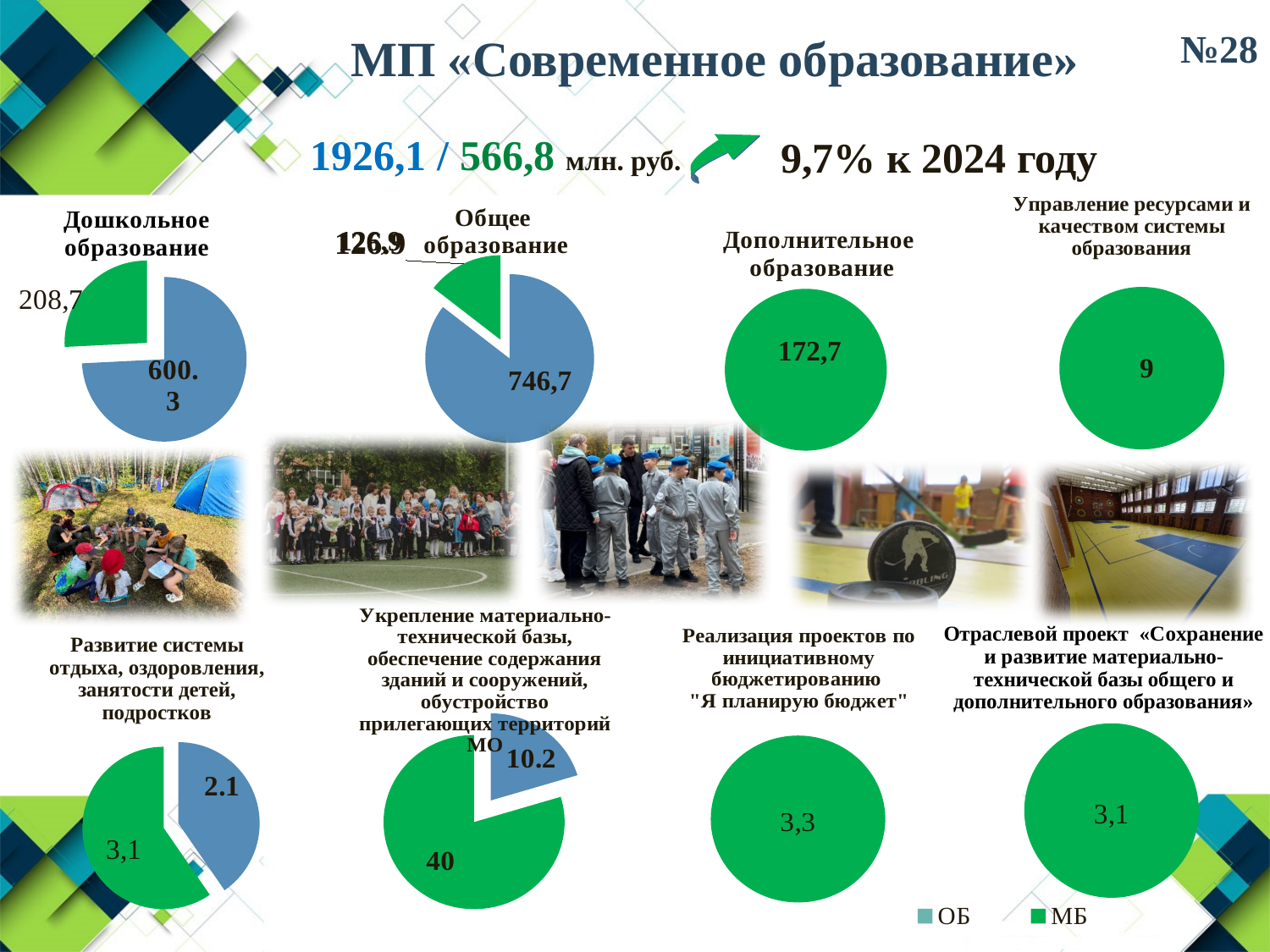
In the "Отраслевой проект" chart, what value is shown? 3,1 In the "Укрепление материально-технической базы" chart, what is the difference between the МБ slice and the ОБ slice? 29.8 In the "Реализация проектов по инициативному бюджетированию" chart, what value is shown? 3,3 In the "Развитие системы отдыха, оздоровления, занятости детей, подростков" chart, what is the value of the blue (ОБ) slice? 2.1 In the "Общее образование" chart, what is the value of the blue slice? 746,7 In the "Дополнительное образование" chart, what value is shown? 172,7 In the "Укрепление материально-технической базы" chart, what is the value of the green (МБ) slice? 40 In the "Управление ресурсами и качеством системы образования" chart, what value is shown? 9 What are the two entries in the legend at the bottom of the slide? ОБ and МБ In the "Общее образование" chart, which slice is larger, the blue one or the green one? blue What kind of chart is used for "Дополнительное образование"? pie chart In the "Укрепление материально-технической базы" chart, what is the value of the blue (ОБ) slice? 10.2